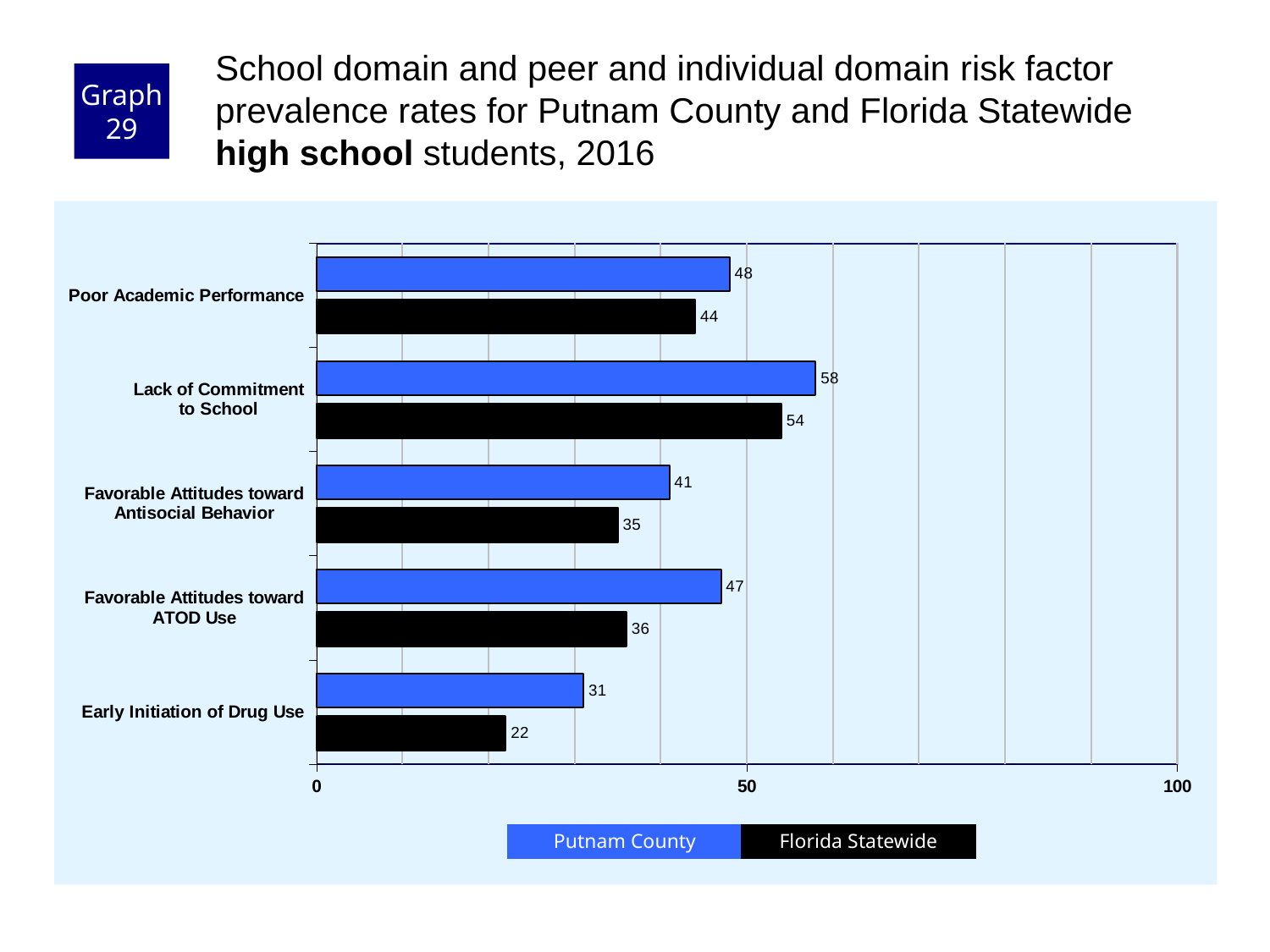
How many risk factors are shown on the chart? 5 What is the difference between the Putnam County and Florida Statewide values for Favorable Attitudes toward ATOD Use? 11 What is the Florida Statewide value for Favorable Attitudes toward ATOD Use? 36 Which risk factor has the highest Putnam County value? Lack of Commitment to School Is the Florida Statewide value for Lack of Commitment to School greater or less than 50? greater What is the Florida Statewide value for Early Initiation of Drug Use? 22 How many series does the legend list? 2 What is the difference between the Putnam County and Florida Statewide values for Poor Academic Performance? 4 What is the Putnam County value for Lack of Commitment to School? 58 What kind of chart is shown on the slide? bar chart Which is larger for Favorable Attitudes toward Antisocial Behavior: the Putnam County value or the Florida Statewide value? Putnam County Which risk factor has the lowest Florida Statewide value? Early Initiation of Drug Use